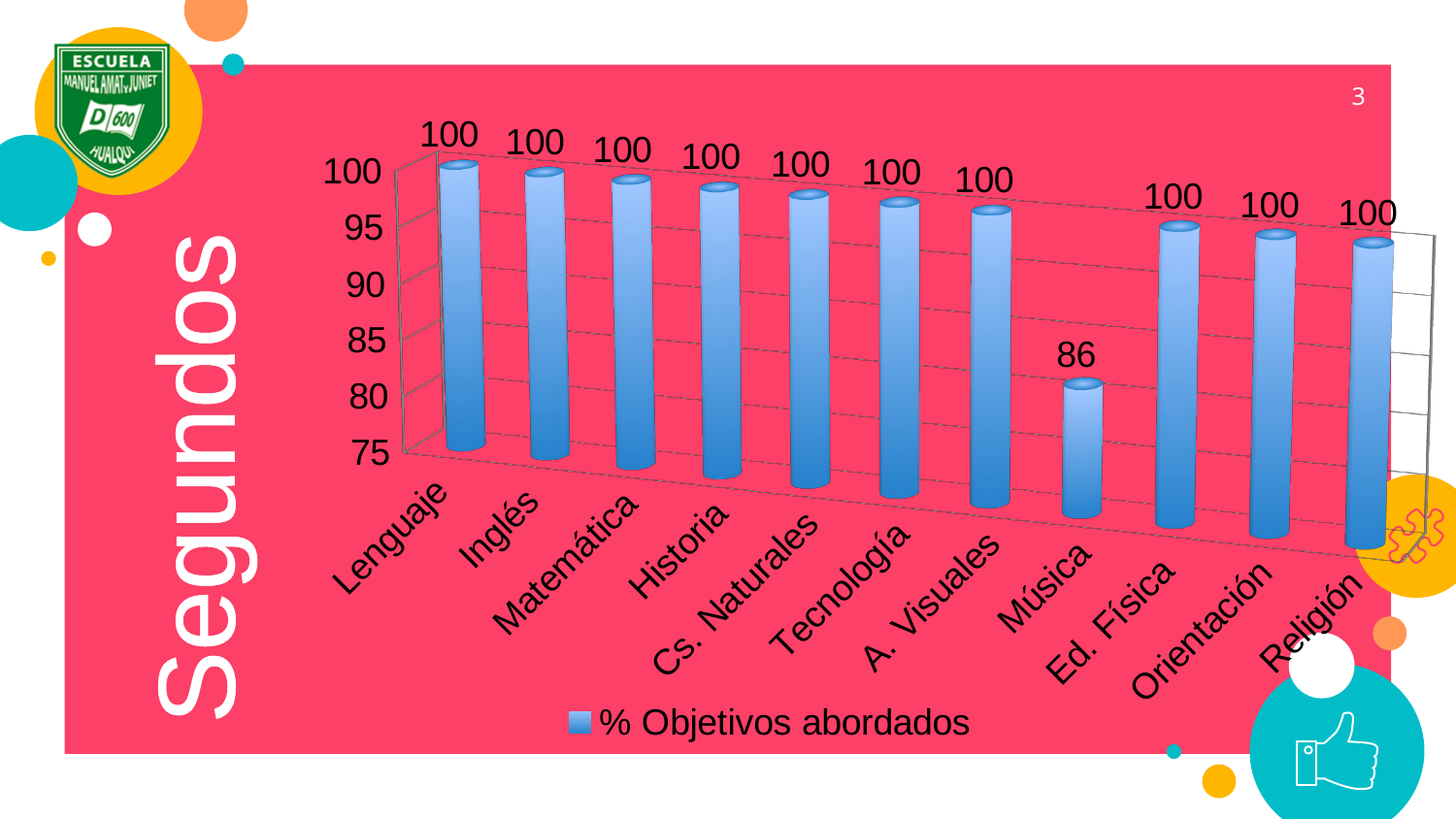
What kind of chart is shown? bar chart Which is larger, the value for Ed. Física or the value for Música? Ed. Física How many categories have a value of 100? 10 Is the value for Música greater or less than 90? less What is the value for Religión? 100 Which category has the lowest value? Música What is the legend entry for the series? % Objetivos abordados How many series does the legend list? 1 What is the value for Música? 86 What is the value for Lenguaje? 100 How many categories are shown on the x axis? 11 What is the difference between the values for Historia and Música? 14